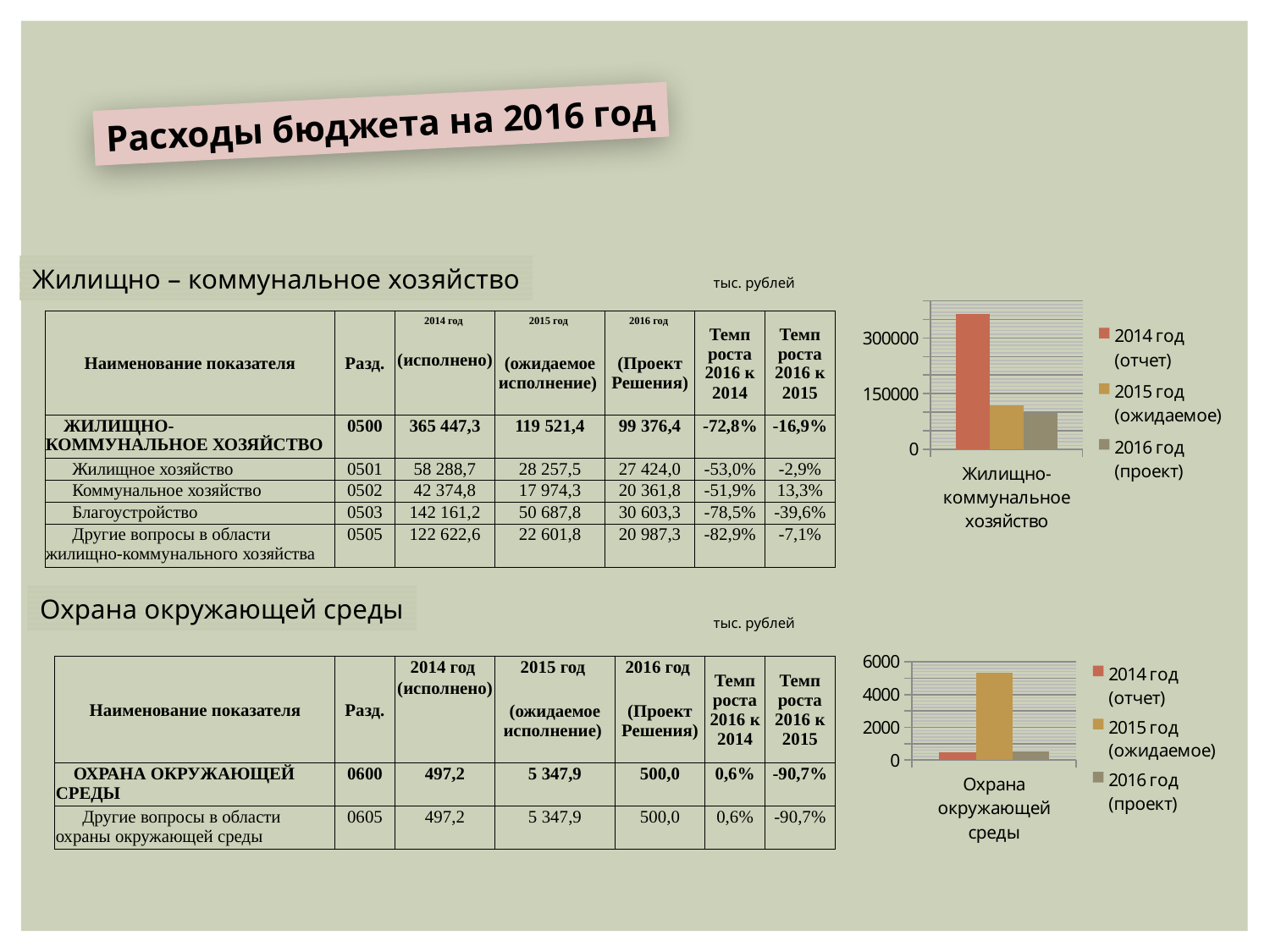
In the Охрана окружающей среды chart, what colour is the bar for 2015 год (ожидаемое)? yellow/gold In the Жилищно-коммунальное хозяйство chart, is the value for 2015 год (ожидаемое) greater or less than 150000? less In the Жилищно-коммунальное хозяйство chart, which series has the shortest bar? 2016 год (проект) In the Охрана окружающей среды chart, which series has the tallest bar? 2015 год (ожидаемое) In the Охрана окружающей среды chart, is the value for 2014 год (отчет) greater or less than 2000? less In the Охрана окружающей среды chart, is the value for 2015 год (ожидаемое) greater or less than 4000? greater In the Жилищно-коммунальное хозяйство chart, how many series does the legend list? 3 In the Жилищно-коммунальное хозяйство chart, which series has the tallest bar? 2014 год (отчет) What type of chart is shown next to the Жилищно – коммунальное хозяйство table? bar chart In the Охрана окружающей среды chart, how many categories are shown on the x axis? 1 In the Жилищно-коммунальное хозяйство chart, which is larger: the bar for 2015 год (ожидаемое) or the bar for 2016 год (проект)? 2015 год (ожидаемое)